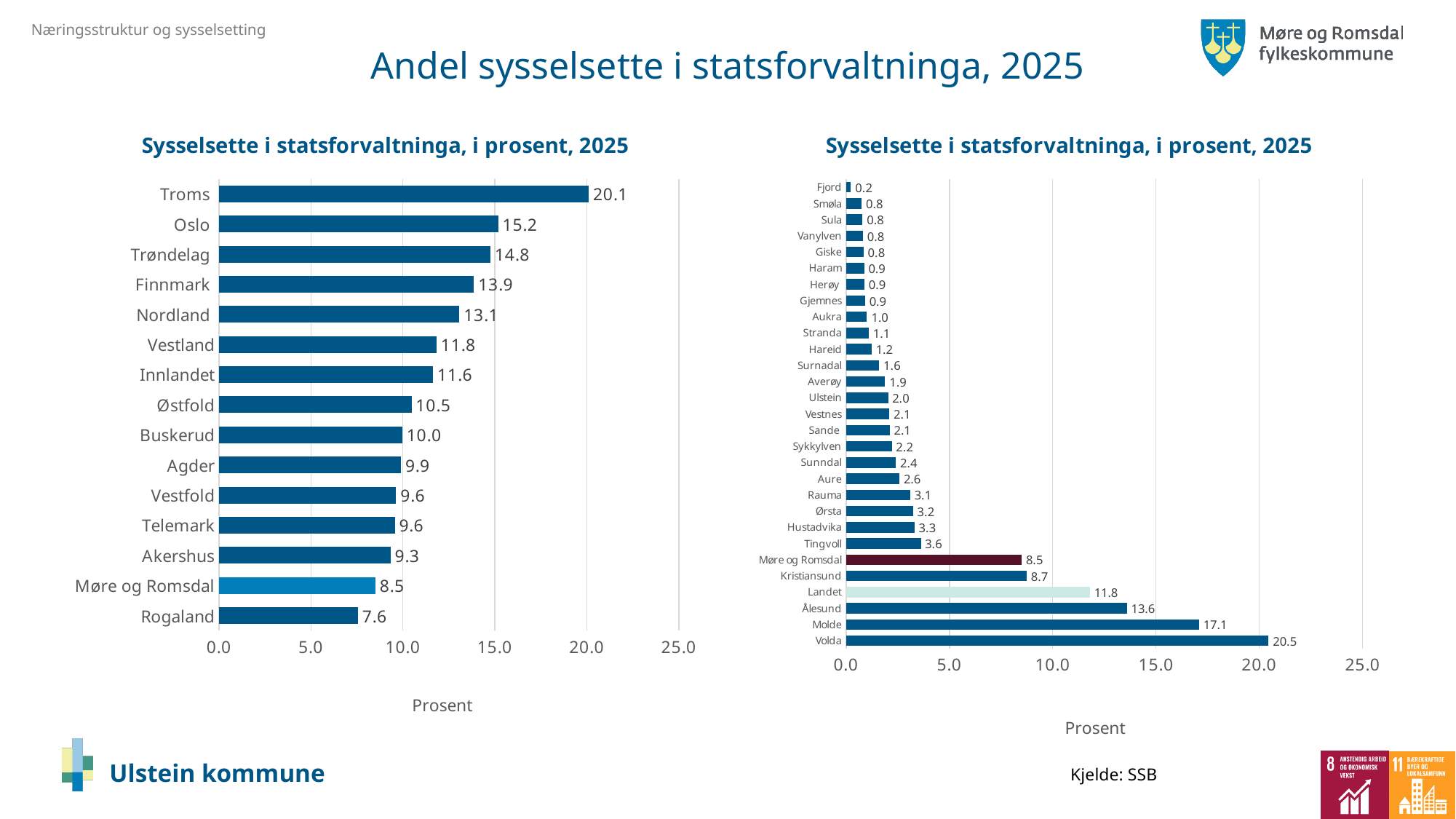
In the right chart, what is the value for Ulstein? 2.0 How many categories are shown in the left chart? 15 What type of chart is the right chart? Bar chart In the right chart, which category has the lowest value? Fjord In the left chart, what is the value for Troms? 20.1 In the left chart, which is larger, Nordland or Vestland? Nordland In the left chart, what is the value for Møre og Romsdal? 8.5 In the right chart, what is the difference between Molde and Ålesund? 3.5 In the left chart, which category has the lowest value? Rogaland In the right chart, which category has the highest value? Volda How many categories are shown in the right chart? 29 In the left chart, what is the difference between Oslo and Trøndelag? 0.4